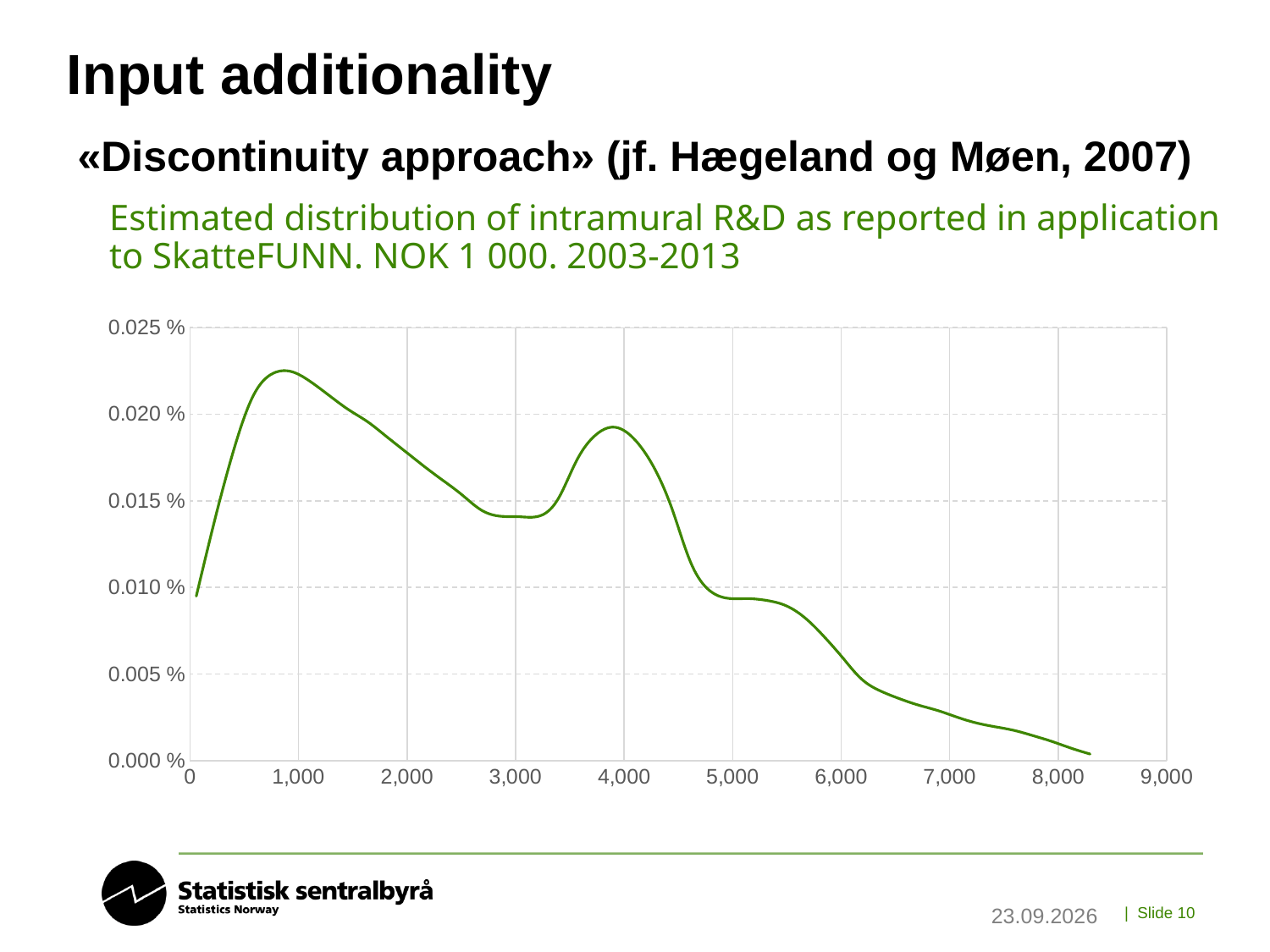
Is the value of the curve at 7,000 greater or less than 0.005 %? less Is the value of the curve at 1,000 greater or less than 0.020 %? greater Does the curve rise or fall between 5,000 and 8,000 on the x axis? fall Is the value of the curve at 3,000 greater or less than 0.010 %? greater Does the curve rise or fall between 0 and 1,000 on the x axis? rise Which is larger, the value of the curve at 2,000 or at 6,000? 2,000 Which is larger, the value of the curve at 1,000 or at 4,000? 1,000 What is the highest tick value shown on the y axis? 0.025 % What kind of chart is shown on the slide? line chart